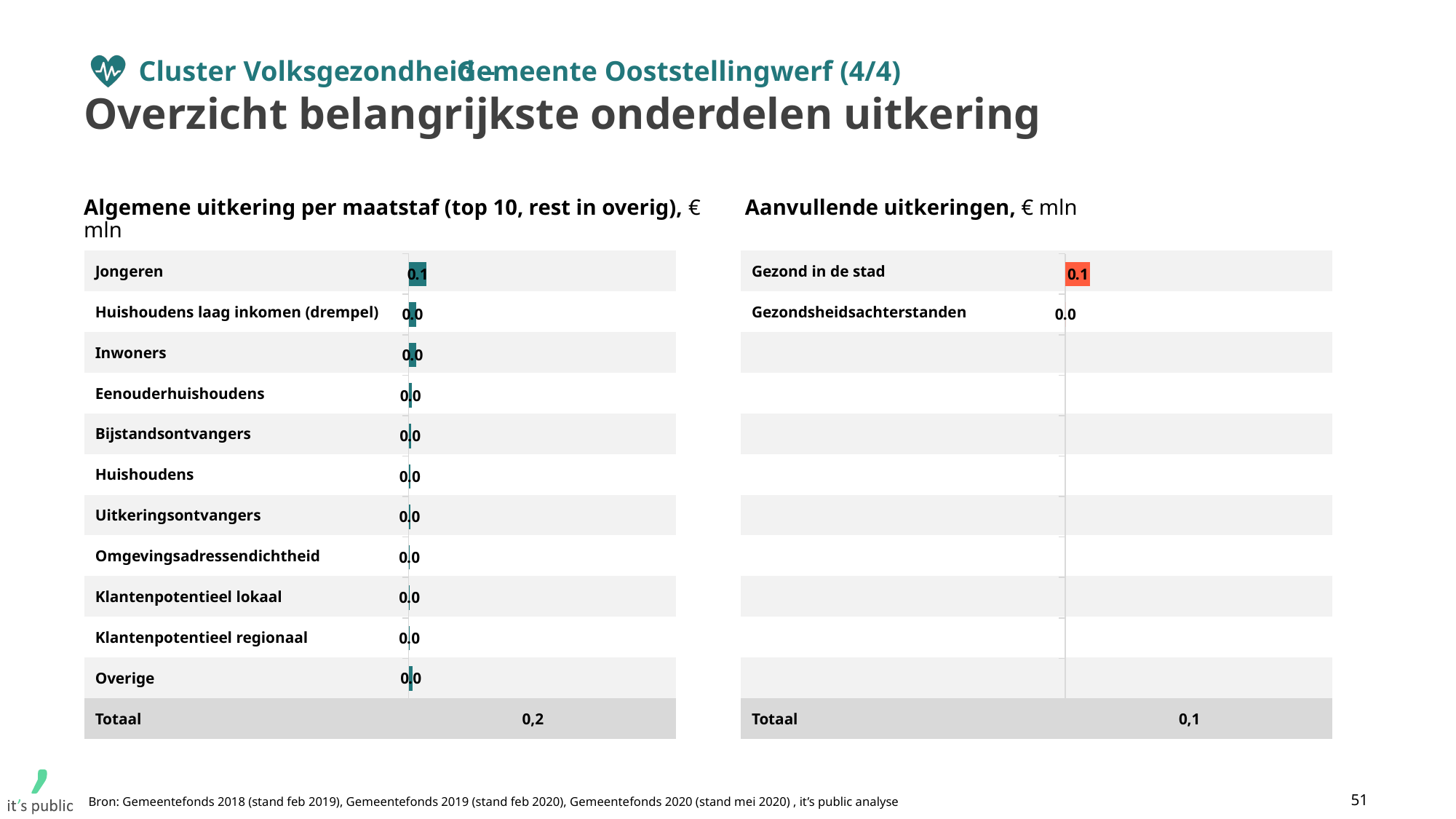
What kind of chart is used on the left side of the slide, 'Algemene uitkering per maatstaf'? Bar chart In the chart 'Algemene uitkering per maatstaf (top 10, rest in overig)', what is the value for Overige? 0.0 In the chart 'Algemene uitkering per maatstaf (top 10, rest in overig)', which is larger: Jongeren or Huishoudens laag inkomen (drempel)? Jongeren In the chart 'Aanvullende uitkeringen', what is the value for Gezond in de stad? 0.1 In the chart 'Aanvullende uitkeringen', how many categories have a value shown? 2 In the chart 'Algemene uitkering per maatstaf (top 10, rest in overig)', which category has the highest value? Jongeren In the chart 'Algemene uitkering per maatstaf (top 10, rest in overig)', how many categories are shown (excluding the Totaal row)? 11 In the chart 'Algemene uitkering per maatstaf (top 10, rest in overig)', what is the value for Jongeren? 0.1 In the chart 'Aanvullende uitkeringen', what is the Totaal value? 0,1 In the chart 'Algemene uitkering per maatstaf (top 10, rest in overig)', what is the Totaal value? 0,2 In the chart 'Aanvullende uitkeringen', which category has the highest value? Gezond in de stad In the chart 'Aanvullende uitkeringen', what is the value for Gezondsheidsachterstanden? 0.0